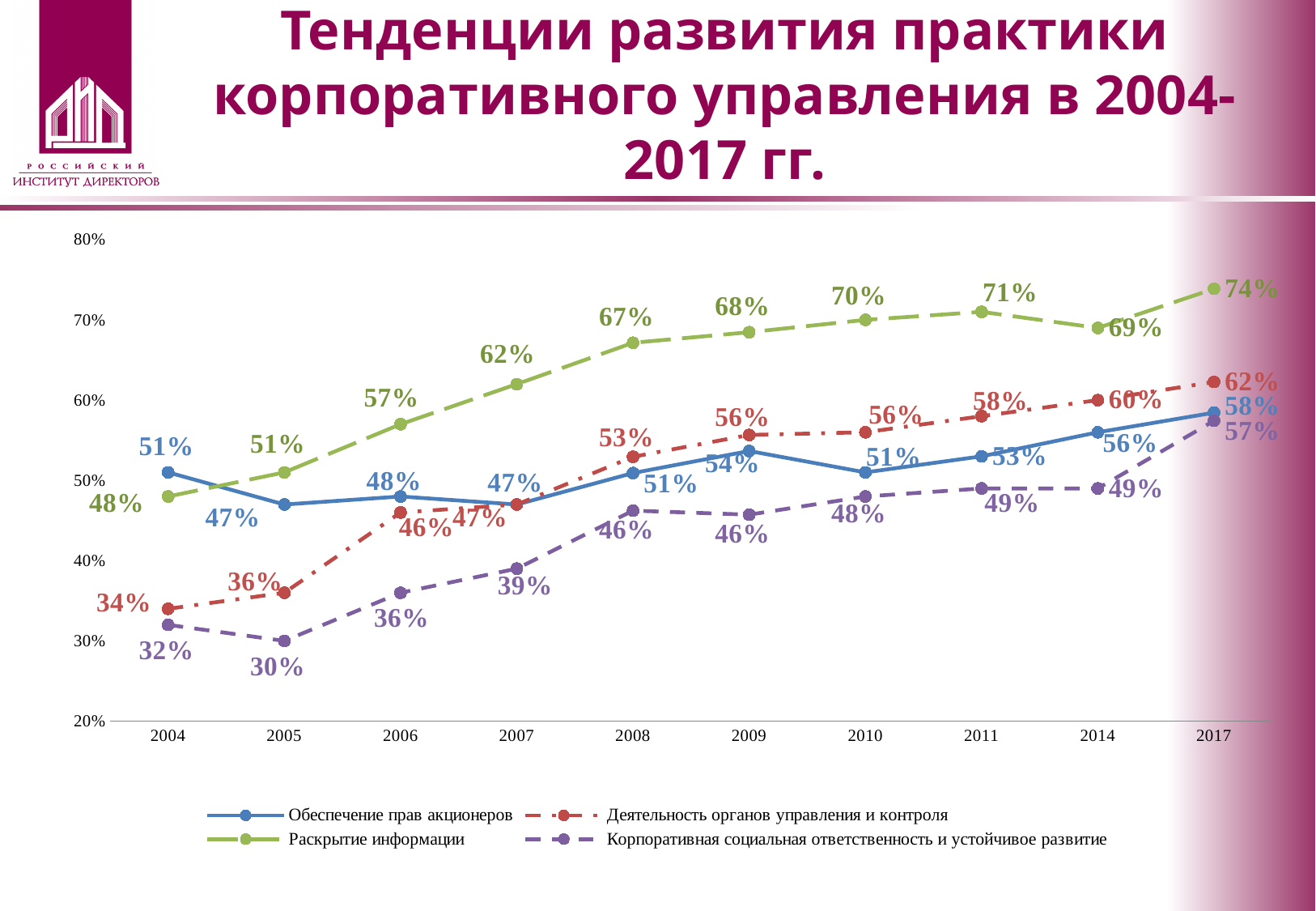
What type of chart is shown on the slide? line chart How many years are plotted along the x axis? 10 What is the difference between the 2017 values for Раскрытие информации and Обеспечение прав акционеров? 16% Which series is drawn with a green dashed line? Раскрытие информации Which series has the higher value in 2004: Обеспечение прав акционеров or Раскрытие информации? Обеспечение прав акционеров What is the value for Раскрытие информации in 2017? 74% What is the value for Корпоративная социальная ответственность и устойчивое развитие in 2005? 30% In which year is the value for Деятельность органов управления и контроля lowest? 2004 In which year is the value for Раскрытие информации highest? 2017 Does the value for Деятельность органов управления и контроля generally rise or fall from 2004 to 2017? rise What is the value for Деятельность органов управления и контроля in 2008? 53% How many series does the legend list? 4